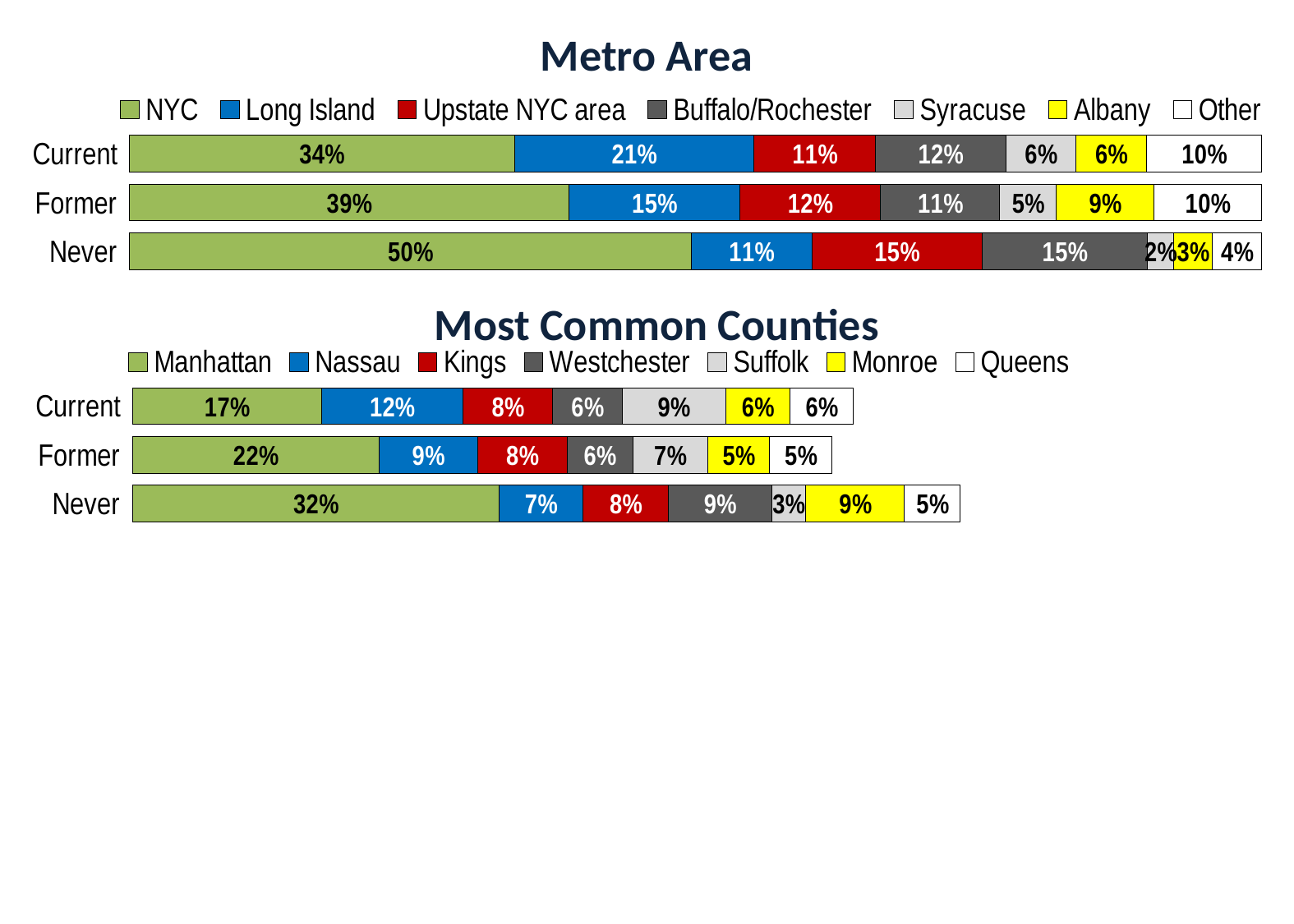
In the Metro Area chart, which group has the lowest Syracuse value? Never In the Metro Area chart, what is the Long Island value for the Current group? 21% In the Metro Area chart, what is the difference between the Albany values for Former and Current? 3% In the Most Common Counties chart, which is larger: the Nassau value for Current or the Nassau value for Former? Current In the Most Common Counties chart, what is the Manhattan value for the Former group? 22% In the Most Common Counties chart, what is the Monroe value for the Never group? 9% In the Metro Area chart, which group has the highest NYC value? Never How many groups (bars) are shown in the Metro Area chart? 3 In the Most Common Counties chart, what is the total of the Never bar? 73% How many series does the legend of the Most Common Counties chart list? 7 What kind of chart is the Most Common Counties chart? Stacked bar chart In the Metro Area chart, what is the NYC value for the Never group? 50%